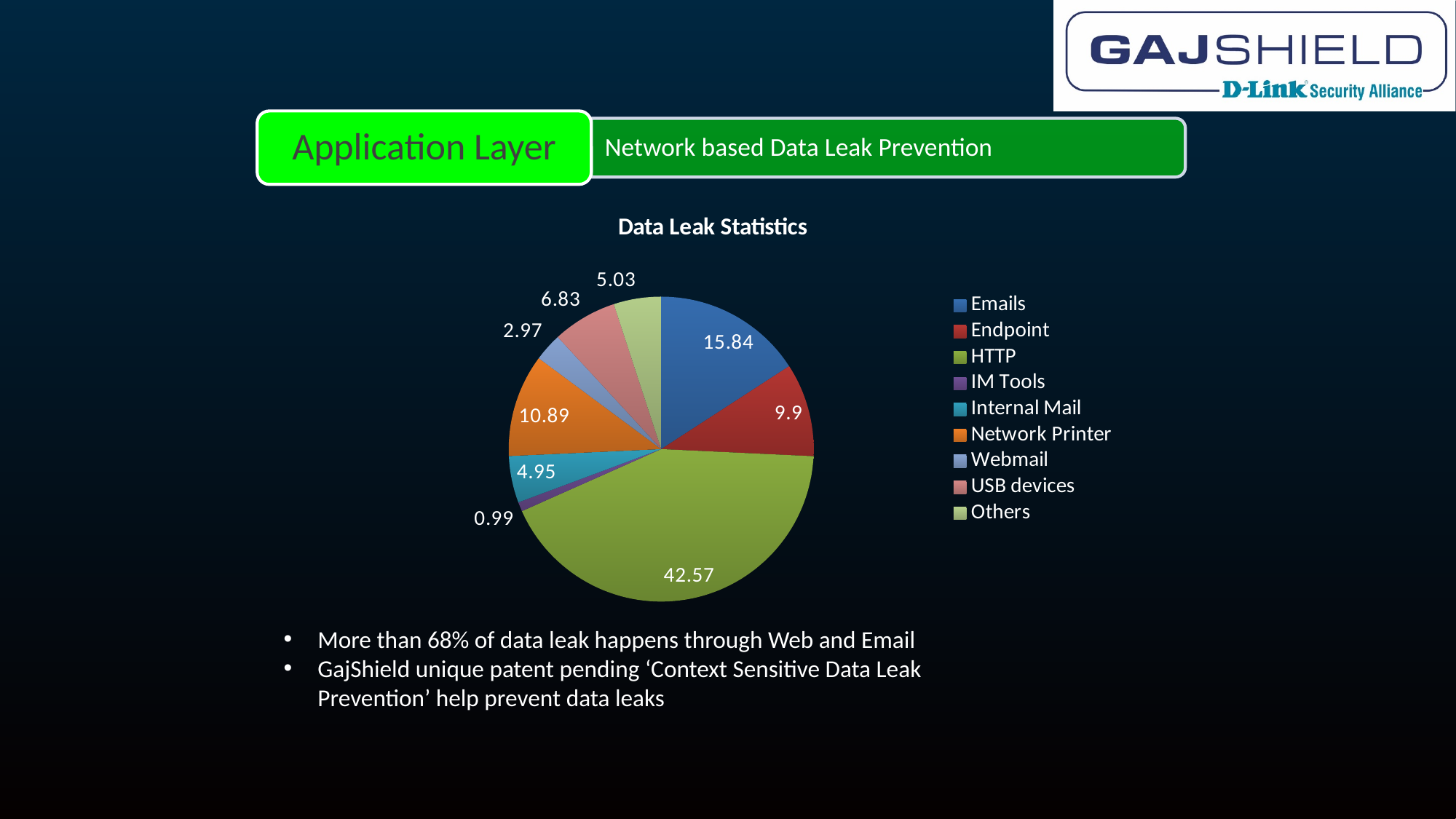
What is the value for Emails in the Data Leak Statistics chart? 15.84 What type of chart is shown on the slide? pie chart What is the value for HTTP in the Data Leak Statistics chart? 42.57 What is the title of the chart? Data Leak Statistics What is the value for Internal Mail in the Data Leak Statistics chart? 4.95 Which category has the smallest slice in the Data Leak Statistics chart? IM Tools What is the difference between the values for HTTP and Emails? 26.73 Which category has the largest slice in the Data Leak Statistics chart? HTTP Which is larger, the value for Endpoint or the value for Network Printer? Network Printer How many categories does the legend of the Data Leak Statistics chart list? 9 What is the value for USB devices in the Data Leak Statistics chart? 6.83 What is the value for Network Printer in the Data Leak Statistics chart? 10.89